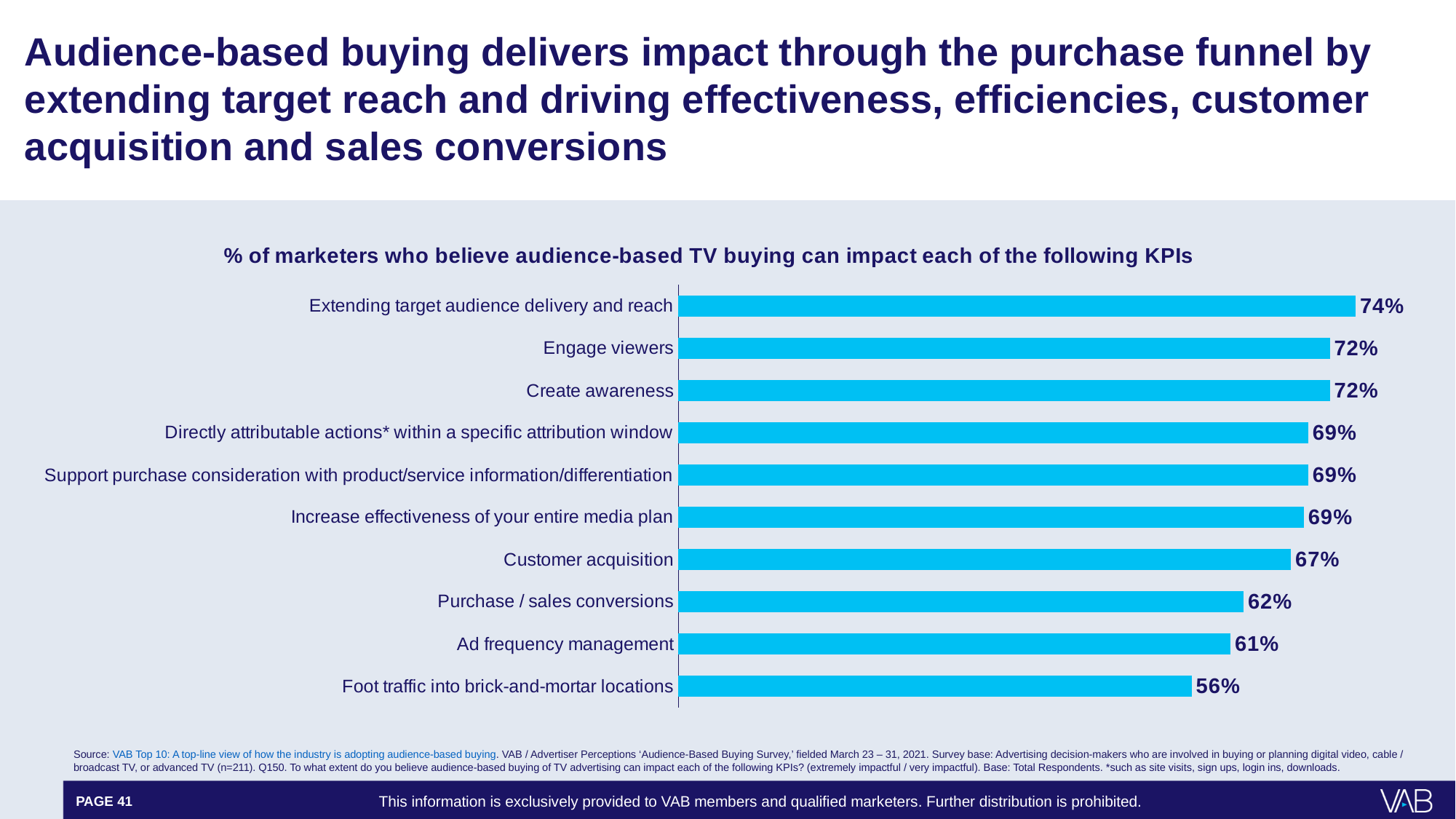
Which KPI has the highest percentage? Extending target audience delivery and reach What is the title of the chart? % of marketers who believe audience-based TV buying can impact each of the following KPIs Which KPI has the lowest percentage? Foot traffic into brick-and-mortar locations What is the value for Foot traffic into brick-and-mortar locations? 56% What is the value for Customer acquisition? 67% How many KPIs are shown in the chart? 10 What is the difference between the values for Extending target audience delivery and reach and Foot traffic into brick-and-mortar locations? 18 percentage points Which is larger: the value for Engage viewers or the value for Ad frequency management? Engage viewers What is the value for Ad frequency management? 61% What is the difference between the values for Customer acquisition and Purchase / sales conversions? 5 percentage points What kind of chart is shown on the slide? Bar chart What percentage of marketers believe audience-based TV buying can impact extending target audience delivery and reach? 74%